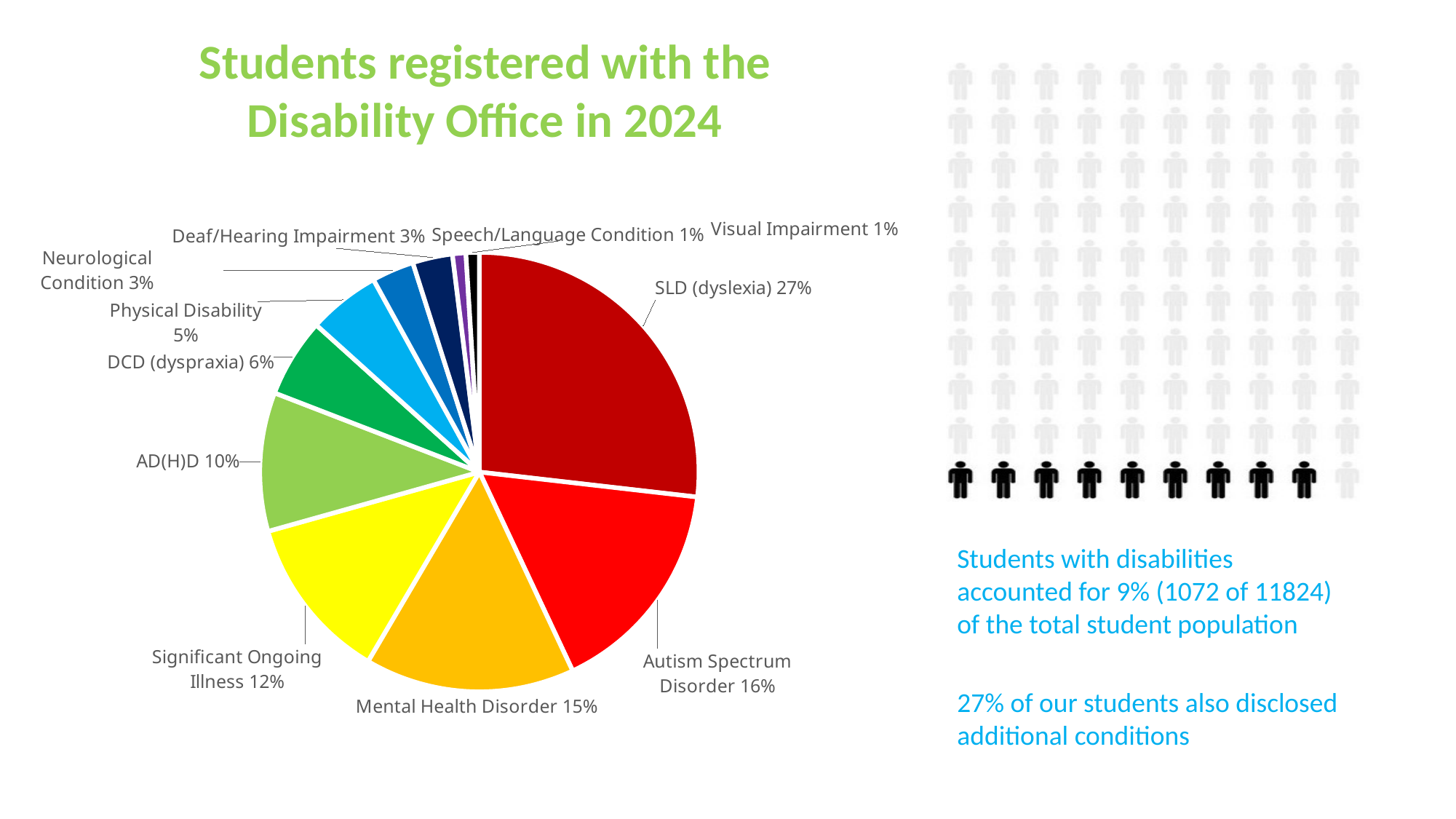
What is the title of the chart? Students registered with the Disability Office in 2024 What percentage is shown for AD(H)D? 10% What percentage is shown for Mental Health Disorder? 15% What is the difference in percentage points between SLD (dyslexia) and Autism Spectrum Disorder? 11 What percentage is shown for Physical Disability? 5% Which category has the largest slice of the pie? SLD (dyslexia) What percentage is shown for Autism Spectrum Disorder? 16% What type of chart is shown on the slide? pie chart What share of the pie is SLD (dyslexia)? 27% What colour is the SLD (dyslexia) slice? dark red Which is larger, Significant Ongoing Illness or DCD (dyspraxia)? Significant Ongoing Illness How many categories are shown in the pie chart? 11